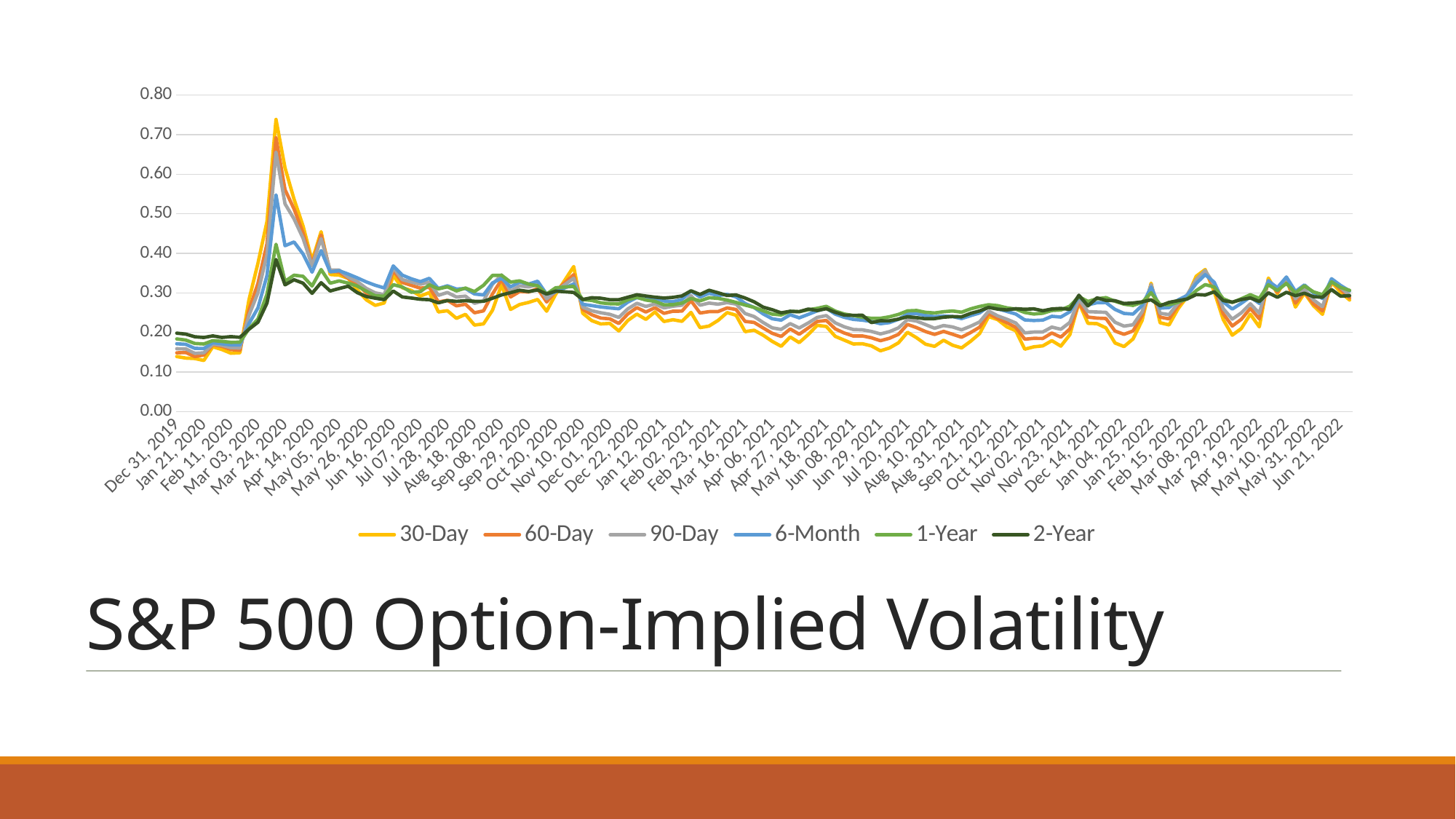
Which series has the lowest peak during the March 2020 spike? 2-Year Is the peak value of the 30-Day series in March 2020 greater or less than 0.70? greater What is the title of the slide? S&P 500 Option-Implied Volatility How many series does the legend list? 6 Around Jul 20, 2021, which is higher: the 30-Day series or the 2-Year series? 2-Year Is the peak value of the 2-Year series in March 2020 greater or less than 0.50? less From the March 2020 peak through mid-2021, does the 30-Day series generally rise or fall? fall Which series reaches the highest peak around Mar 24, 2020? 30-Day Which series is drawn in yellow? 30-Day What kind of chart is shown on the slide? line chart Is the value of the 30-Day series at Dec 31, 2019 greater or less than 0.20? less